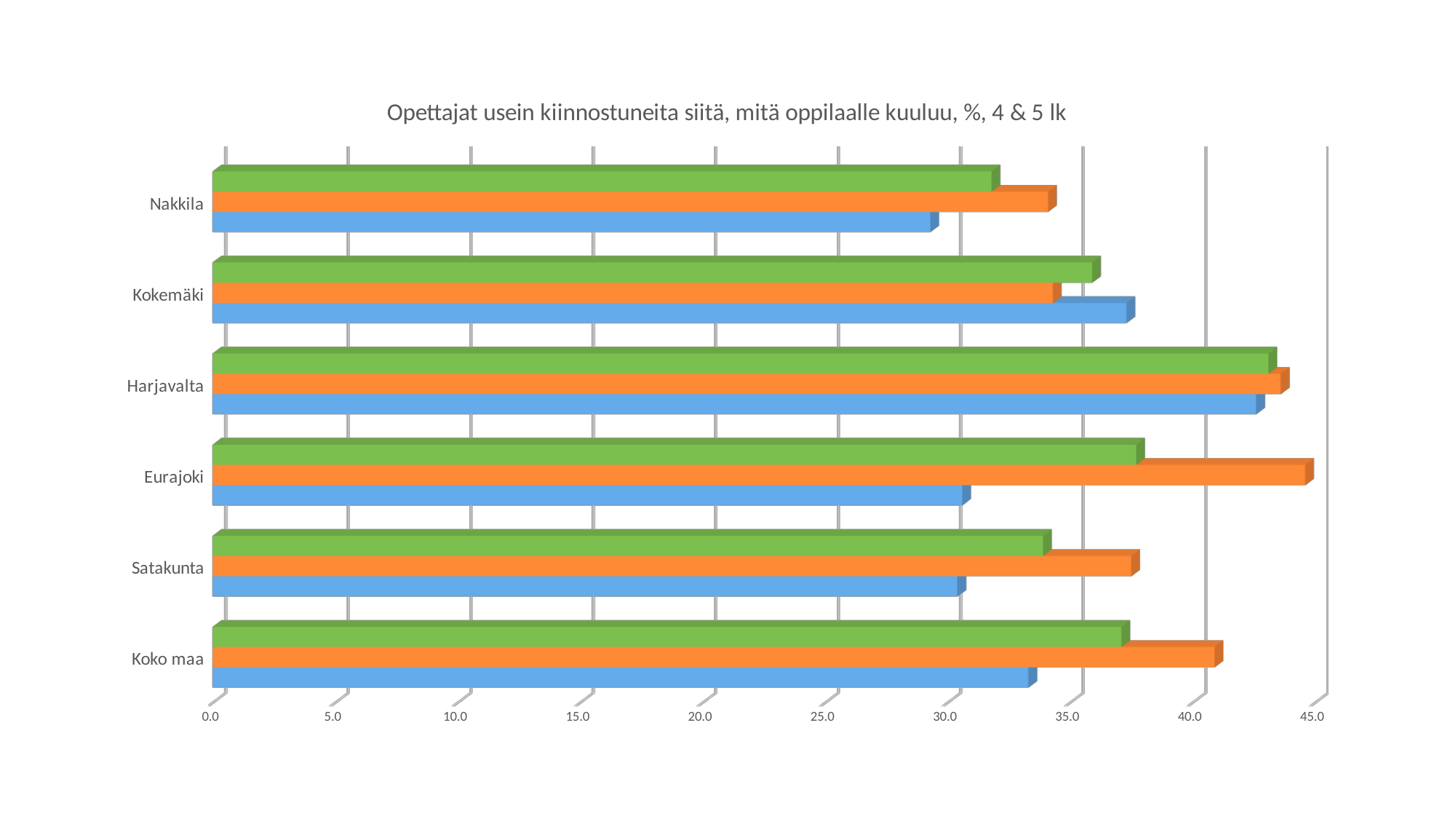
Is the orange bar for Eurajoki greater or less than 40.0? greater For Nakkila, which is longer: the green bar or the blue bar? the green bar What kind of chart is shown on the slide? bar chart Which category has the longest orange bar? Eurajoki What is the highest value shown on the horizontal axis of the chart? 45.0 Which category has the shortest blue bar? Nakkila How many categories (areas) are shown on the vertical axis of the chart? 6 For Kokemäki, which is longer: the blue bar or the orange bar? the blue bar Which category has the longest green bar? Harjavalta Is the blue bar for Satakunta greater or less than 35.0? less How many bars are plotted for each category in the chart? 3 What is the title of the chart? Opettajat usein kiinnostuneita siitä, mitä oppilaalle kuuluu, %, 4 & 5 lk